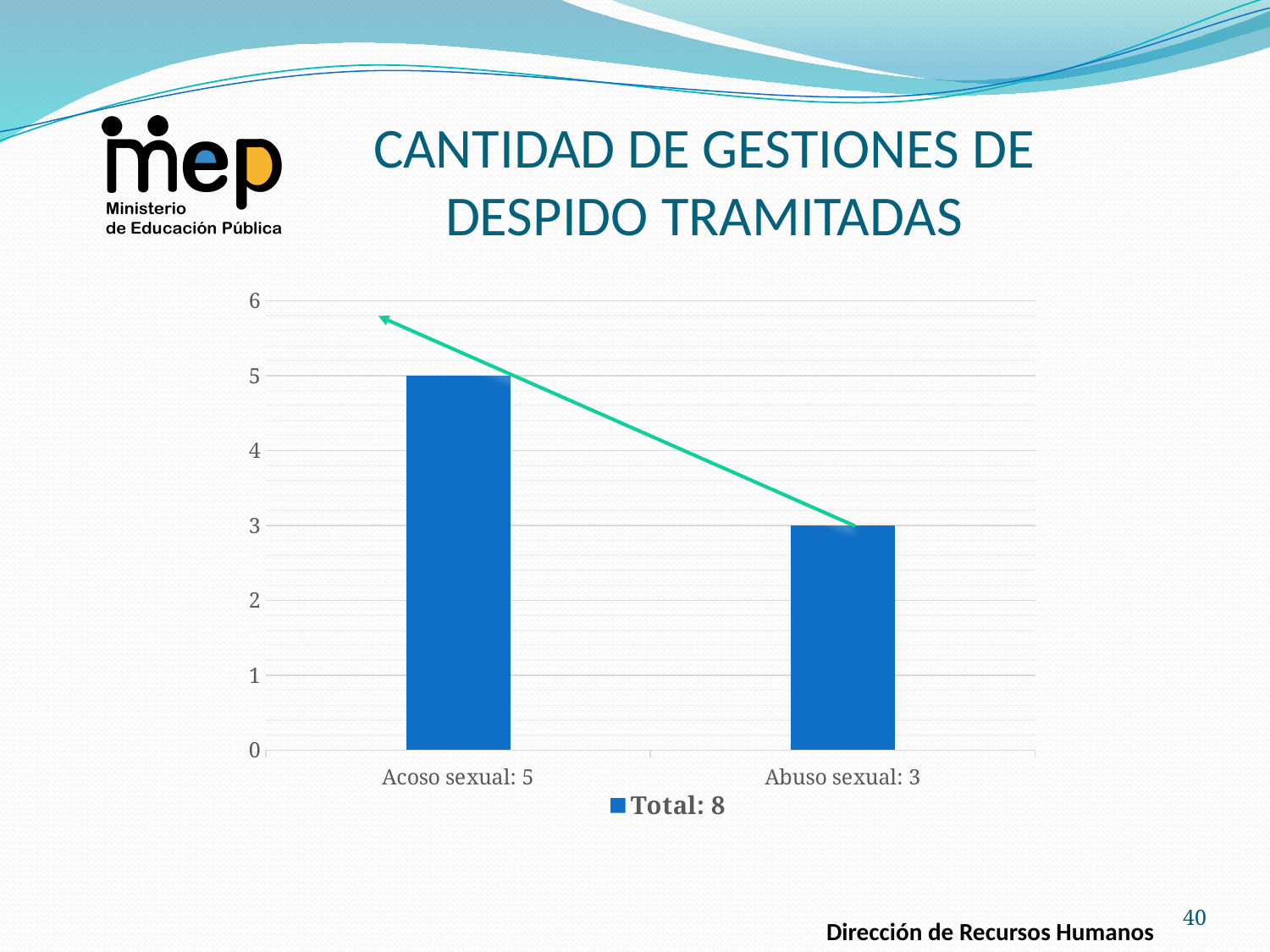
Is the value for Abuso sexual greater or less than 4? less Which is larger, the value for Acoso sexual or the value for Abuso sexual? Acoso sexual What is the legend entry shown below the chart? Total: 8 What is the value for Acoso sexual? 5 What is the difference between the values for Acoso sexual and Abuso sexual? 2 How many categories are shown on the x axis? 2 What kind of chart is shown on the slide? Bar chart Which category has the lowest value? Abuso sexual Which category has the highest value? Acoso sexual Is the value for Acoso sexual greater or less than 4? greater What is the value for Abuso sexual? 3 How many series does the legend list? 1